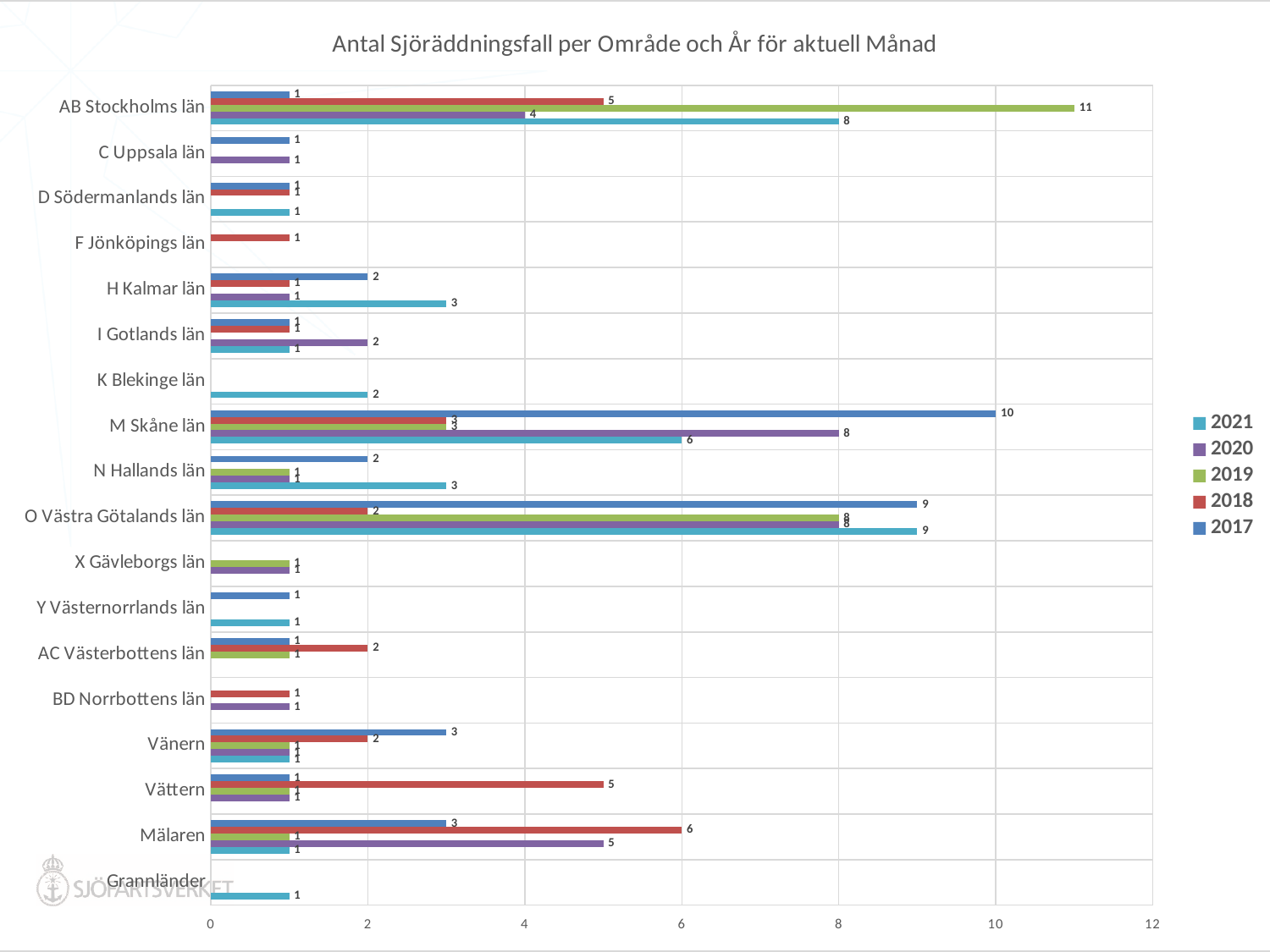
What kind of chart is shown on the slide? bar chart Which is larger, the 2018 value for Mälaren or the 2018 value for Vättern? Mälaren What is the title of the chart? Antal Sjöräddningsfall per Område och År för aktuell Månad Which category has the highest 2019 value? AB Stockholms län What is the difference between the 2017 and 2021 values for M Skåne län? 4 What is the 2021 value for K Blekinge län? 2 How many series does the legend list? 5 What is the 2019 value for AB Stockholms län? 11 What is the 2018 value for Mälaren? 6 Which category has the highest 2017 value? M Skåne län What is the difference between the 2019 and 2020 values for AB Stockholms län? 7 What is the 2017 value for M Skåne län? 10